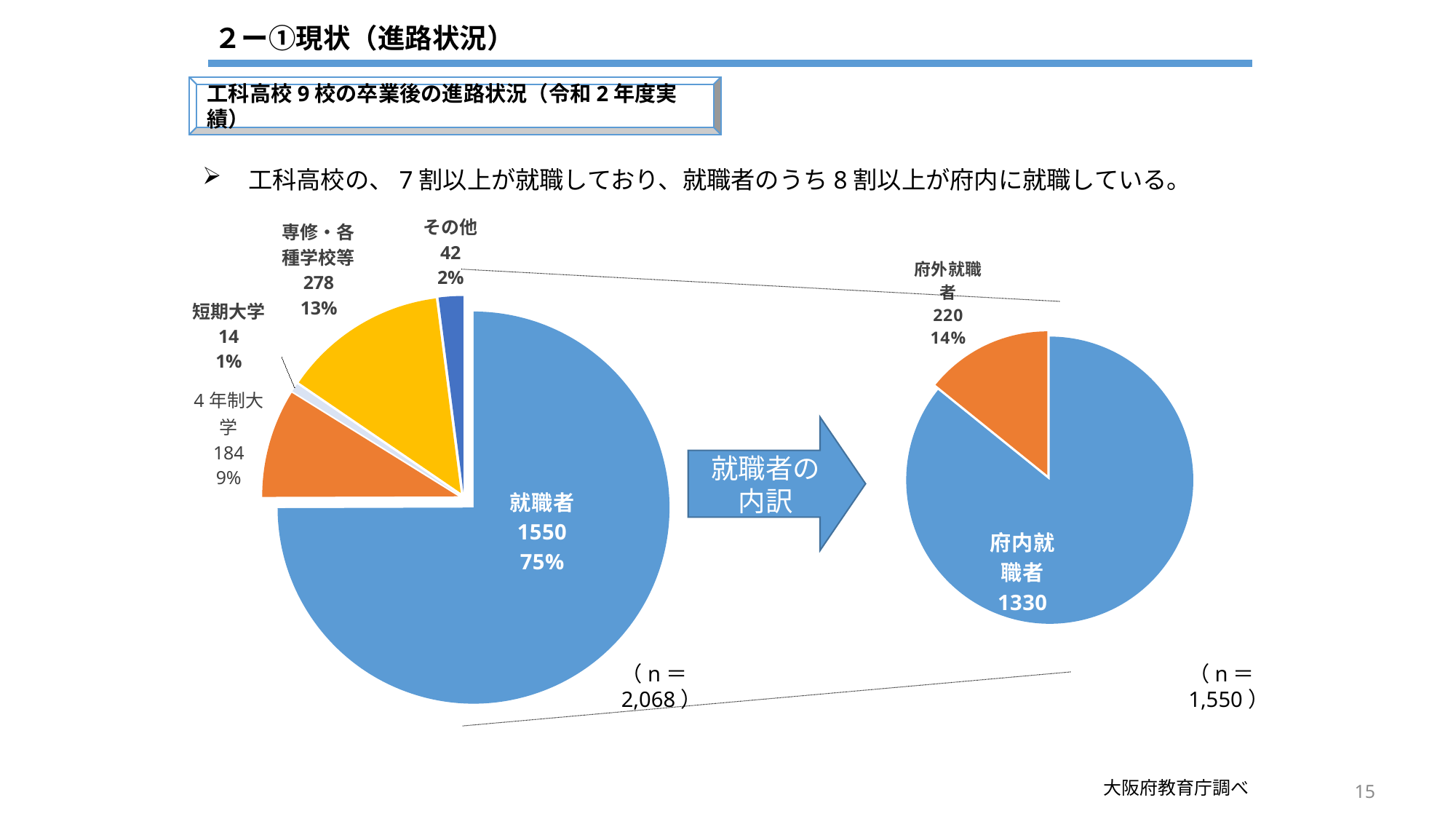
In the left pie chart, how many graduates are in the 就職者 category? 1550 In the left pie chart, which category has the smallest slice? 短期大学 In the left pie chart, which is larger, その他 or 短期大学? その他 In the left pie chart, how many categories are shown? 5 In the left pie chart, what is the difference between the values for 専修・各種学校等 and 4年制大学? 94 In the right pie chart, what percentage share is shown for 府外就職者? 14% What is the n value shown for the right pie chart? 1,550 In the left pie chart, which category has the largest slice? 就職者 In the left pie chart, what percentage share is shown for 専修・各種学校等? 13% In the right pie chart, what is the value shown for 府内就職者? 1330 What kind of chart is used on the right side of the slide? Pie chart In the left pie chart, what is the value shown for 4年制大学? 184